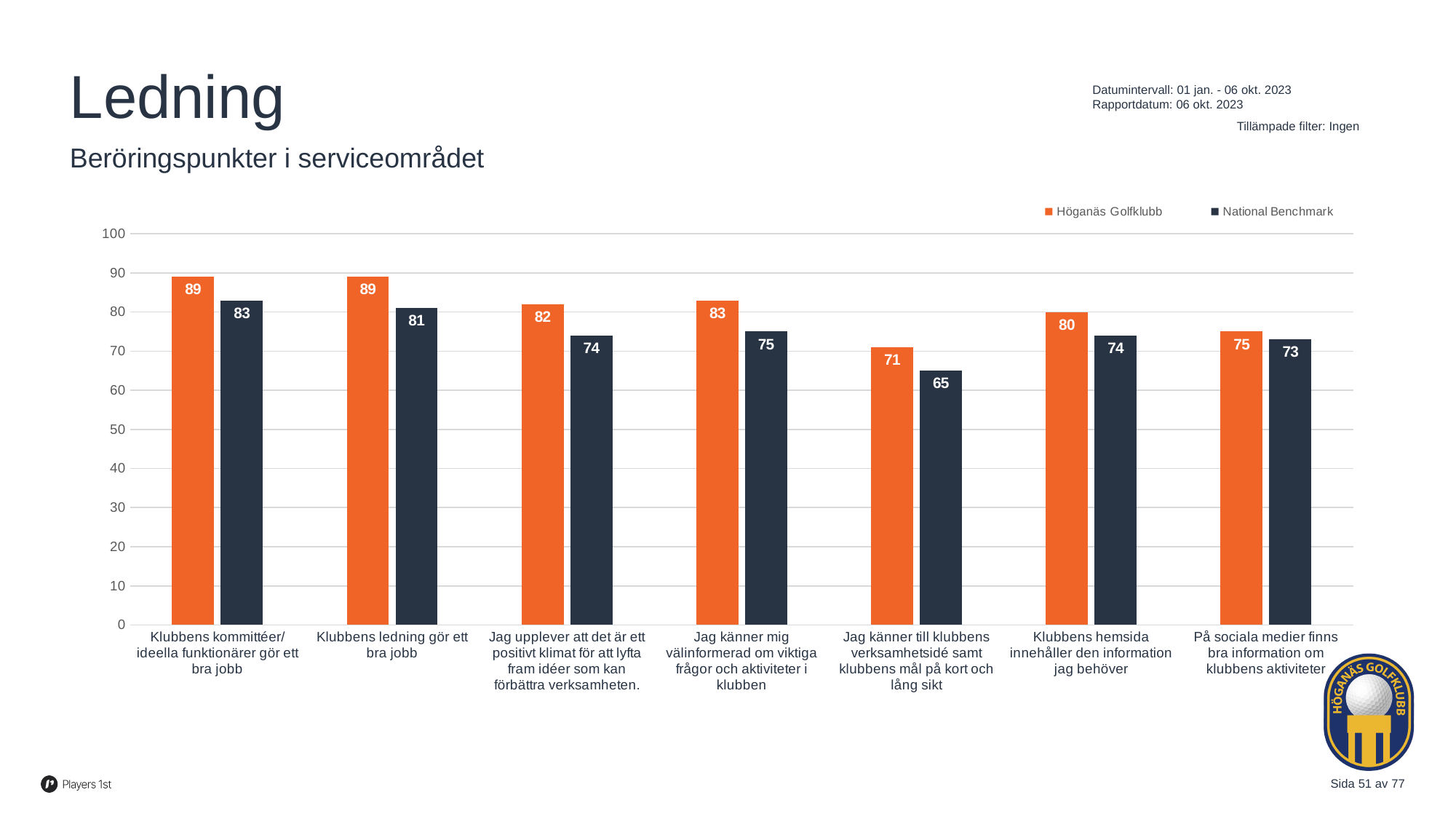
What is the National Benchmark value for "Jag känner till klubbens verksamhetsidé samt klubbens mål på kort och lång sikt"? 65 How many series does the legend list? 2 Which category has the highest National Benchmark value? Klubbens kommittéer/ideella funktionärer gör ett bra jobb What kind of chart is shown on the slide? Bar chart What is the difference between the Höganäs Golfklubb and National Benchmark values for "Jag upplever att det är ett positivt klimat för att lyfta fram idéer som kan förbättra verksamheten."? 8 Which colour represents Höganäs Golfklubb in the chart? Orange Is the National Benchmark value for "Jag känner mig välinformerad om viktiga frågor och aktiviteter i klubben" greater or less than 70? greater How many categories are shown on the x axis? 7 Which category has the lowest Höganäs Golfklubb value? Jag känner till klubbens verksamhetsidé samt klubbens mål på kort och lång sikt What is the Höganäs Golfklubb value for "Klubbens ledning gör ett bra jobb"? 89 What is the Höganäs Golfklubb value for "Klubbens hemsida innehåller den information jag behöver"? 80 For "På sociala medier finns bra information om klubbens aktiviteter", which is larger: Höganäs Golfklubb or National Benchmark? Höganäs Golfklubb